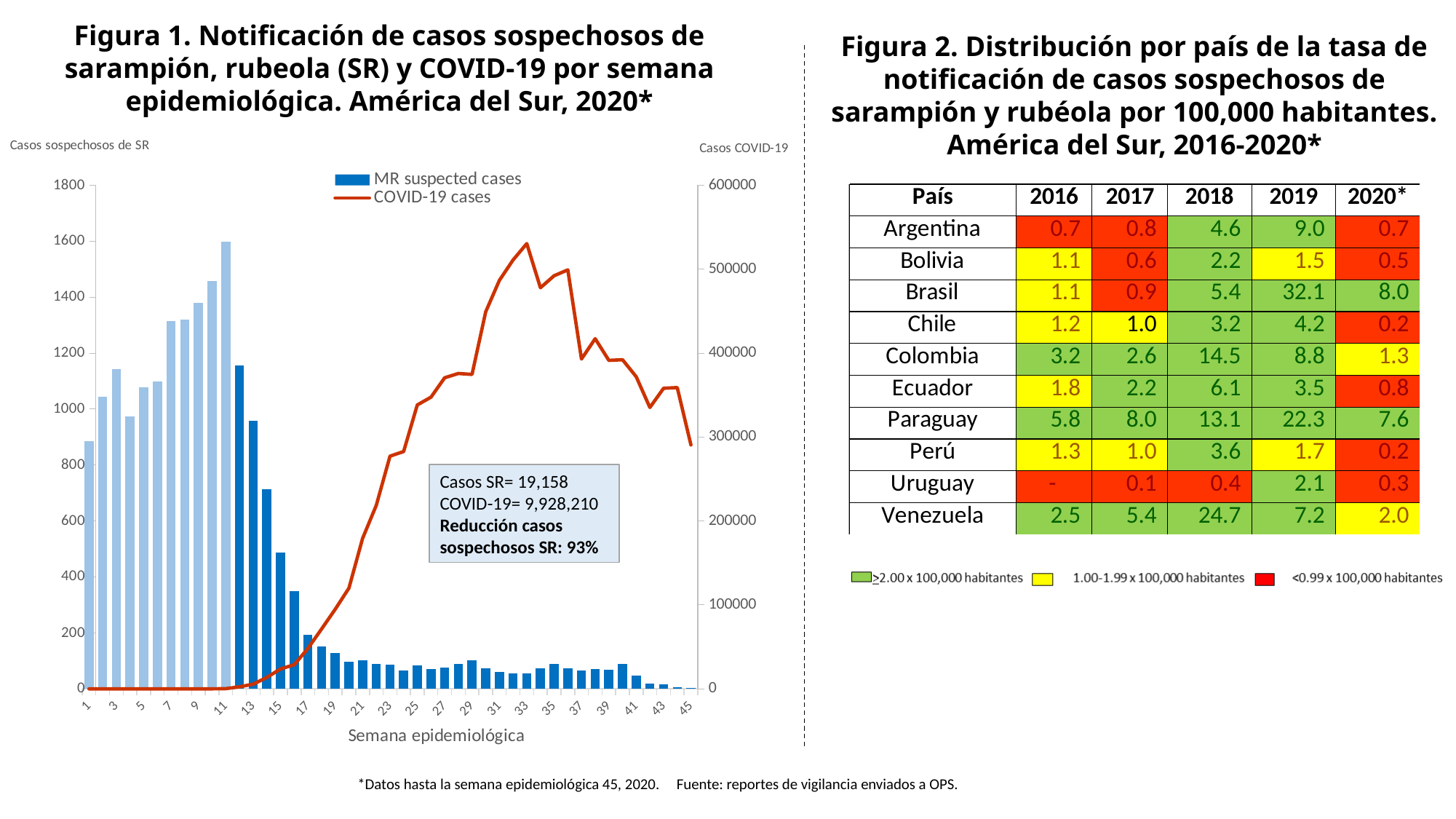
In Figura 1, what is the title of the x axis? Semana epidemiológica In Figura 1, how many epidemiological weeks are plotted on the x axis? 45 In Figura 1, do the MR suspected cases bars rise or fall from week 11 to week 20? Fall In Figura 1, which has more MR suspected cases, week 13 or week 15? Week 13 In Figura 1, what total number of suspected SR cases is given in the text box? 19,158 In Figura 1, what are the two series named in the legend? MR suspected cases and COVID-19 cases In Figura 1, is the MR suspected cases bar for week 45 greater or less than 200? less In Figura 1, how many series does the legend list? 2 In Figura 1, which epidemiological week has the highest bar of MR suspected cases? Week 11 In Figura 1, what kind of chart is used to show the MR suspected cases and COVID-19 cases? A combined bar and line chart In Figura 1, is the MR suspected cases bar for week 11 greater or less than 1400? greater In Figura 1, is the peak of the COVID-19 cases line greater or less than 500000? greater